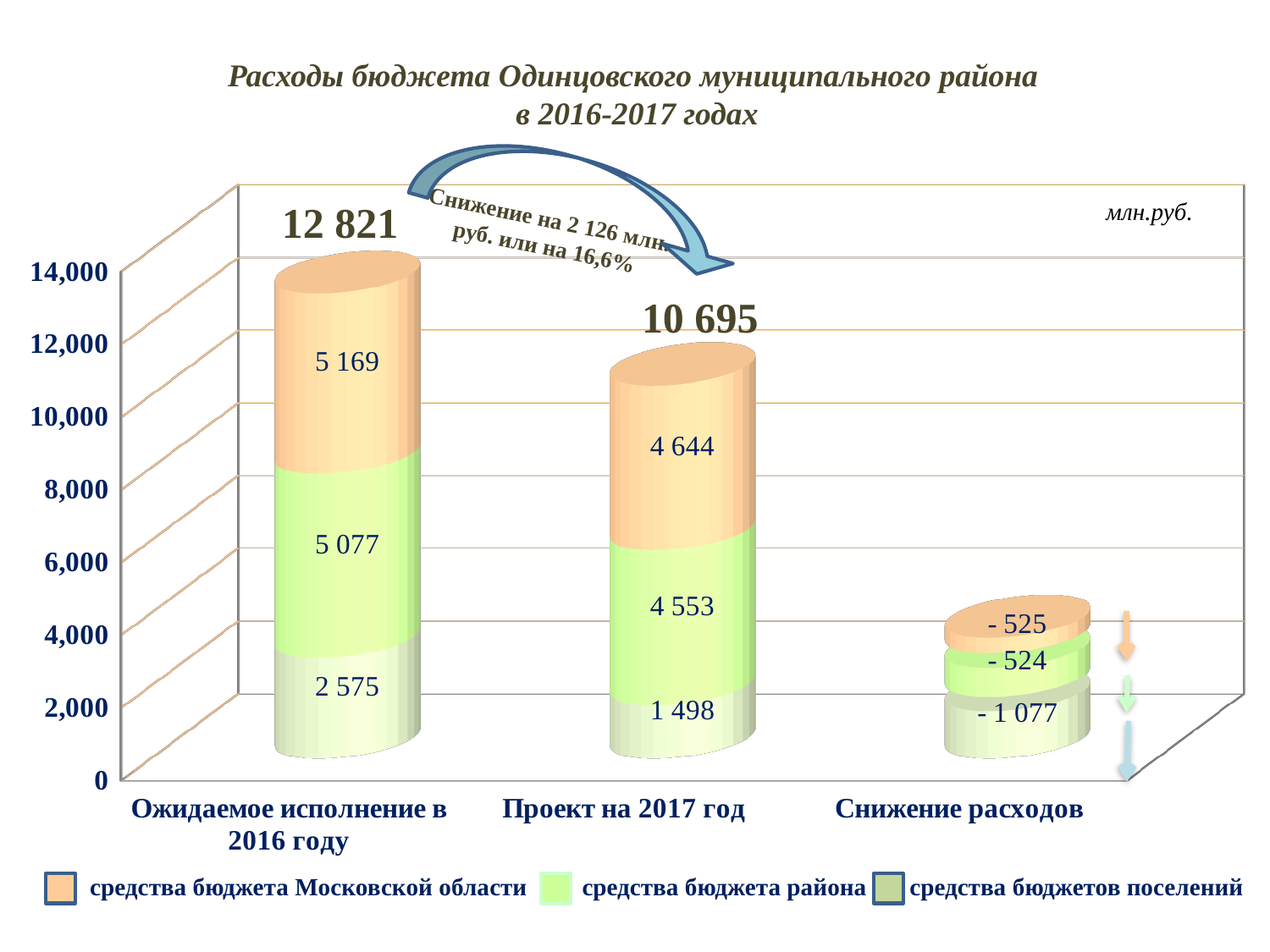
How many categories are shown on the x axis? 3 What is the value of средства бюджетов поселений for Снижение расходов? - 1 077 What is the total of the stacked bar for Проект на 2017 год? 10 695 What is the value of средства бюджетов поселений for Ожидаемое исполнение в 2016 году? 2 575 What unit of measurement is indicated on the chart? млн.руб. What is the value of средства бюджета района for Проект на 2017 год? 4 553 Which is larger: средства бюджета района for Ожидаемое исполнение в 2016 году or for Проект на 2017 год? Ожидаемое исполнение в 2016 году What is the total of the stacked bar for Ожидаемое исполнение в 2016 году? 12 821 What is the difference between the totals for Ожидаемое исполнение в 2016 году and Проект на 2017 год? 2 126 What is the value of средства бюджета Московской области for Ожидаемое исполнение в 2016 году? 5 169 What type of chart is shown on the slide? stacked bar chart How many series does the legend list? 3